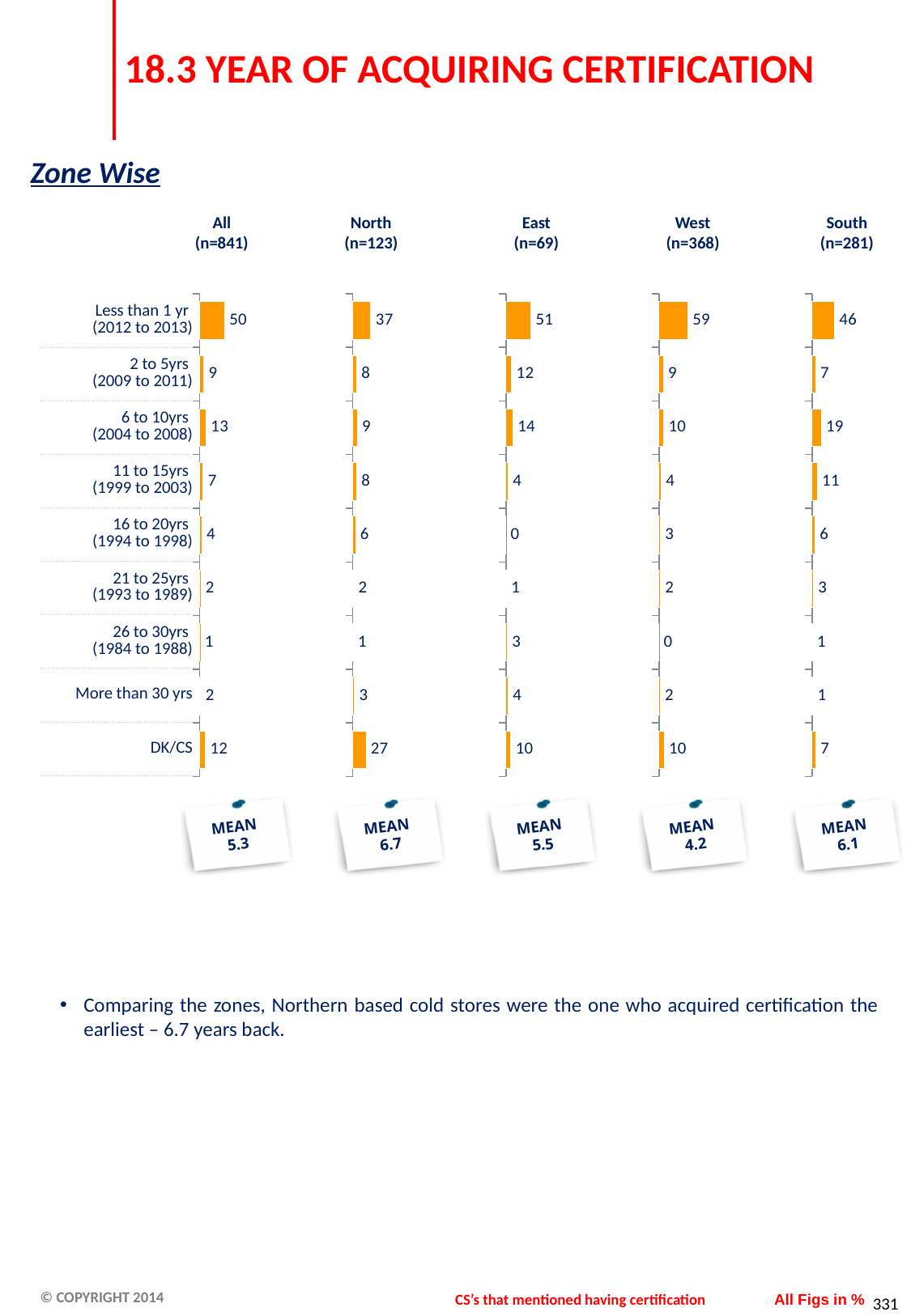
How many categories are shown in each of the zone-wise bar charts? 9 In the East (n=69) chart, what is the value for 16 to 20yrs (1994 to 1998)? 0 In the North (n=123) chart, what is the value for 16 to 20yrs (1994 to 1998)? 6 In the All (n=841) chart, what is the value for Less than 1 yr (2012 to 2013)? 50 What type of chart is used for the All (n=841) data? Bar chart In the West (n=368) chart, what is the difference between the values for Less than 1 yr (2012 to 2013) and DK/CS? 49 In the West (n=368) chart, which category has the lowest value? 26 to 30yrs (1984 to 1988) What is the mean shown below the West (n=368) chart? 4.2 In the North (n=123) chart, what is the value for DK/CS? 27 Which is larger: the value for 2 to 5yrs (2009 to 2011) in the East (n=69) chart or in the South (n=281) chart? East (n=69) In the South (n=281) chart, what is the value for 6 to 10yrs (2004 to 2008)? 19 In the East (n=69) chart, which category has the highest value? Less than 1 yr (2012 to 2013)